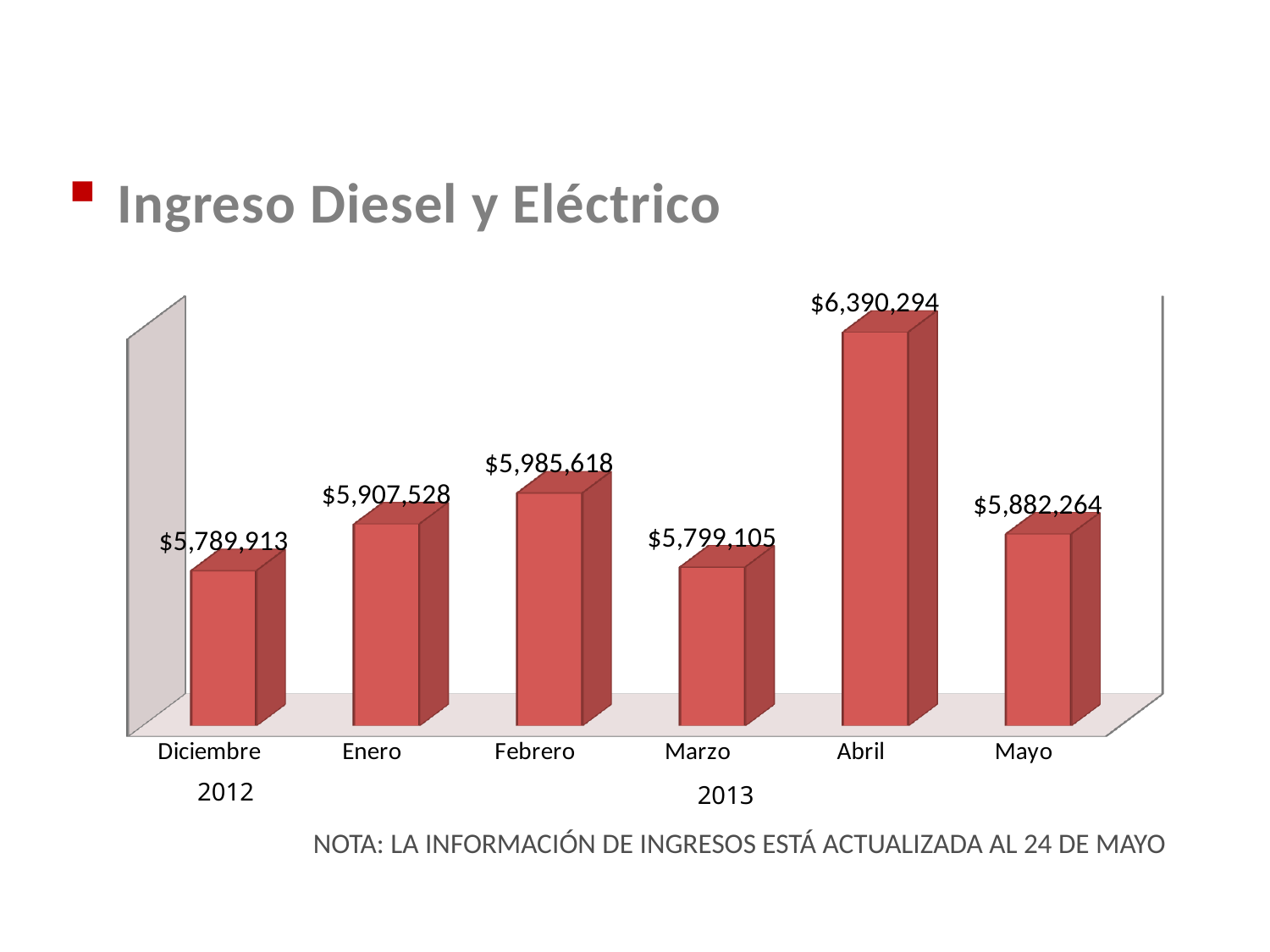
Which is larger, the value for Febrero or the value for Mayo? Febrero What is the difference between the values for Abril and Diciembre? $600,381 What is the title of the chart? Ingreso Diesel y Eléctrico How many months are shown in the chart? 6 What is the difference between the values for Febrero and Enero? $78,090 Which month has the lowest value? Diciembre What kind of chart is shown on the slide? Bar chart What is the value for Abril? $6,390,294 What is the value for Diciembre? $5,789,913 What is the value for Mayo? $5,882,264 What is the value for Marzo? $5,799,105 Which month has the highest value? Abril